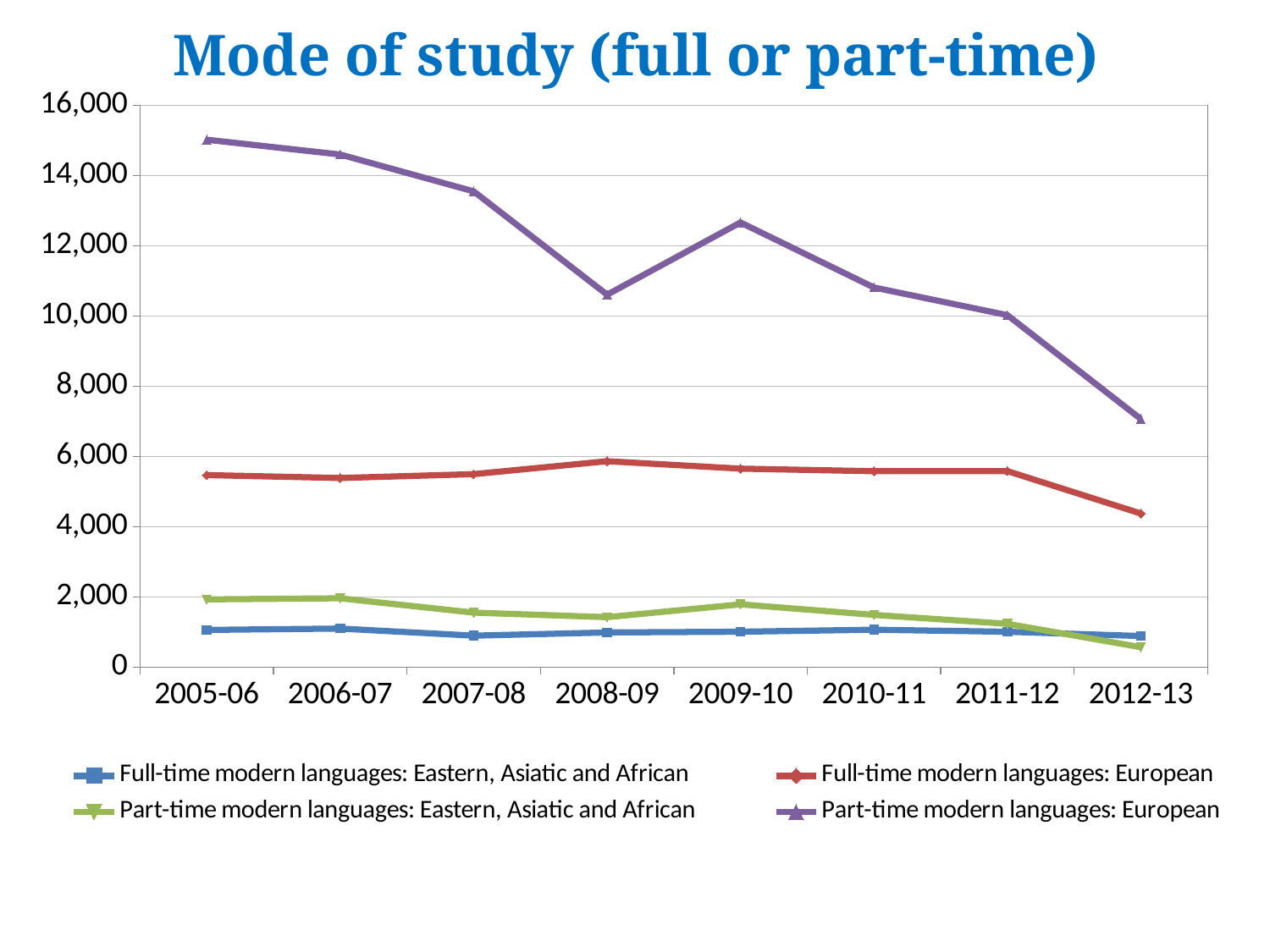
Is the value for Part-time modern languages: European in 2012-13 greater or less than 8,000? less Is the value for Full-time modern languages: Eastern, Asiatic and African in 2005-06 greater or less than 2,000? less How many academic years are plotted along the x axis? 8 What kind of chart is shown on the slide? line chart Does the Part-time modern languages: European series generally rise or fall from 2005-06 to 2012-13? fall In which year is Part-time modern languages: European at its lowest? 2012-13 Is the value for Full-time modern languages: European in 2008-09 greater or less than 4,000? greater In which year is Part-time modern languages: European at its highest? 2005-06 How many series does the legend list? 4 What is the title of the chart? Mode of study (full or part-time) For Part-time modern languages: European, which year has the larger value, 2008-09 or 2009-10? 2009-10